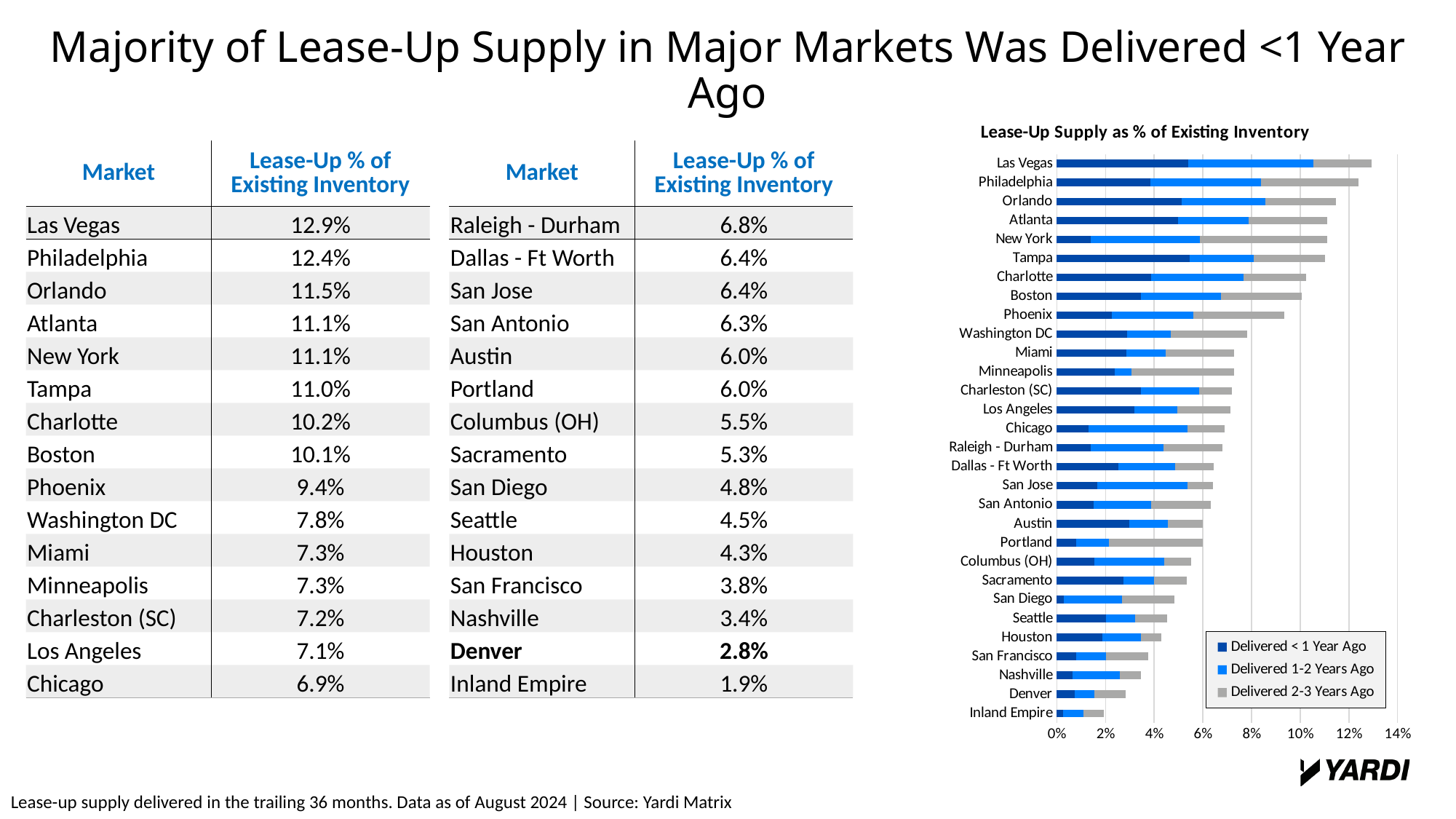
What kind of chart is shown on the slide? Stacked bar chart How many markets are plotted in the chart? 30 Which has a larger total lease-up % of existing inventory, Boston or Phoenix? Boston Which market has the lowest total lease-up supply as % of existing inventory? Inland Empire Which market has the highest total lease-up supply as % of existing inventory? Las Vegas Is the 'Delivered < 1 Year Ago' value for Las Vegas greater or less than 4%? greater Do the total bar lengths rise or fall moving from the top market to the bottom market in the chart? Fall Is the 'Delivered < 1 Year Ago' value for Portland greater or less than 2%? less What is the total lease-up supply as % of existing inventory for Orlando? 11.5% What is the difference between the total lease-up % for Las Vegas and Inland Empire? 11.0% What is the total lease-up supply as % of existing inventory for Denver? 2.8% How many series does the chart legend list? 3